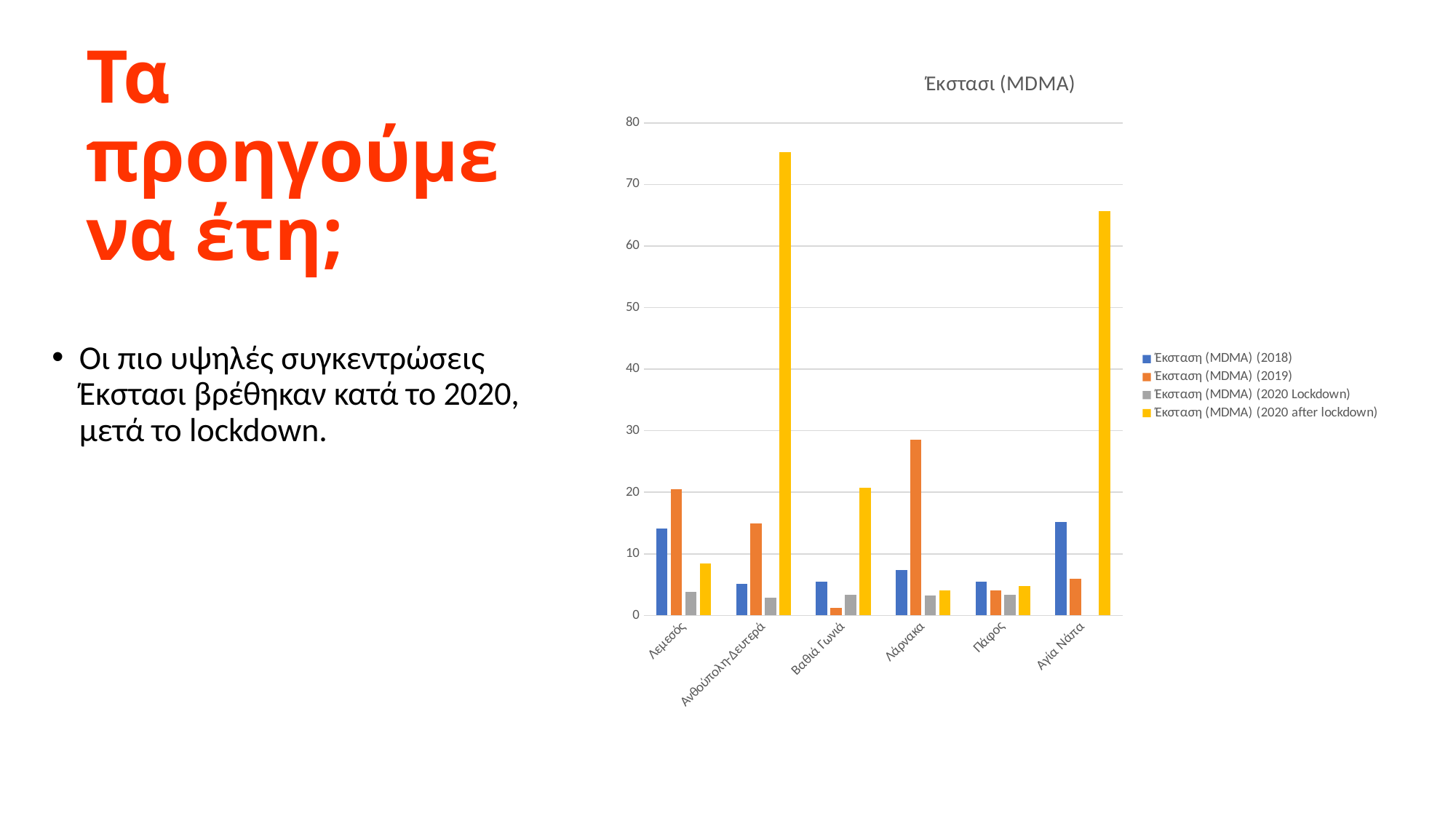
Is the value for Αγία Νάπα in the series Έκσταση (MDMA) (2020 after lockdown) greater or less than 60? greater What is the title of the chart? Έκστασι (MDMA) How many categories (locations) are shown on the x axis of the chart? 6 Which category has the highest value for the series Έκσταση (MDMA) (2020 after lockdown)? Ανθούπολη-Δευτερά Is the value for Λάρνακα in the series Έκσταση (MDMA) (2019) greater or less than 20? greater For the series Έκσταση (MDMA) (2019), which is larger: the value for Λάρνακα or the value for Λεμεσός? Λάρνακα Is the value for Ανθούπολη-Δευτερά in the series Έκσταση (MDMA) (2020 after lockdown) greater or less than 70? greater What colour represents the series Έκσταση (MDMA) (2020 after lockdown) in the chart? yellow Which category has the highest value for the series Έκσταση (MDMA) (2019)? Λάρνακα How many series does the chart's legend list? 4 Which category has the lowest value for the series Έκσταση (MDMA) (2019)? Βαθιά Γωνιά What kind of chart is shown on the slide? bar chart